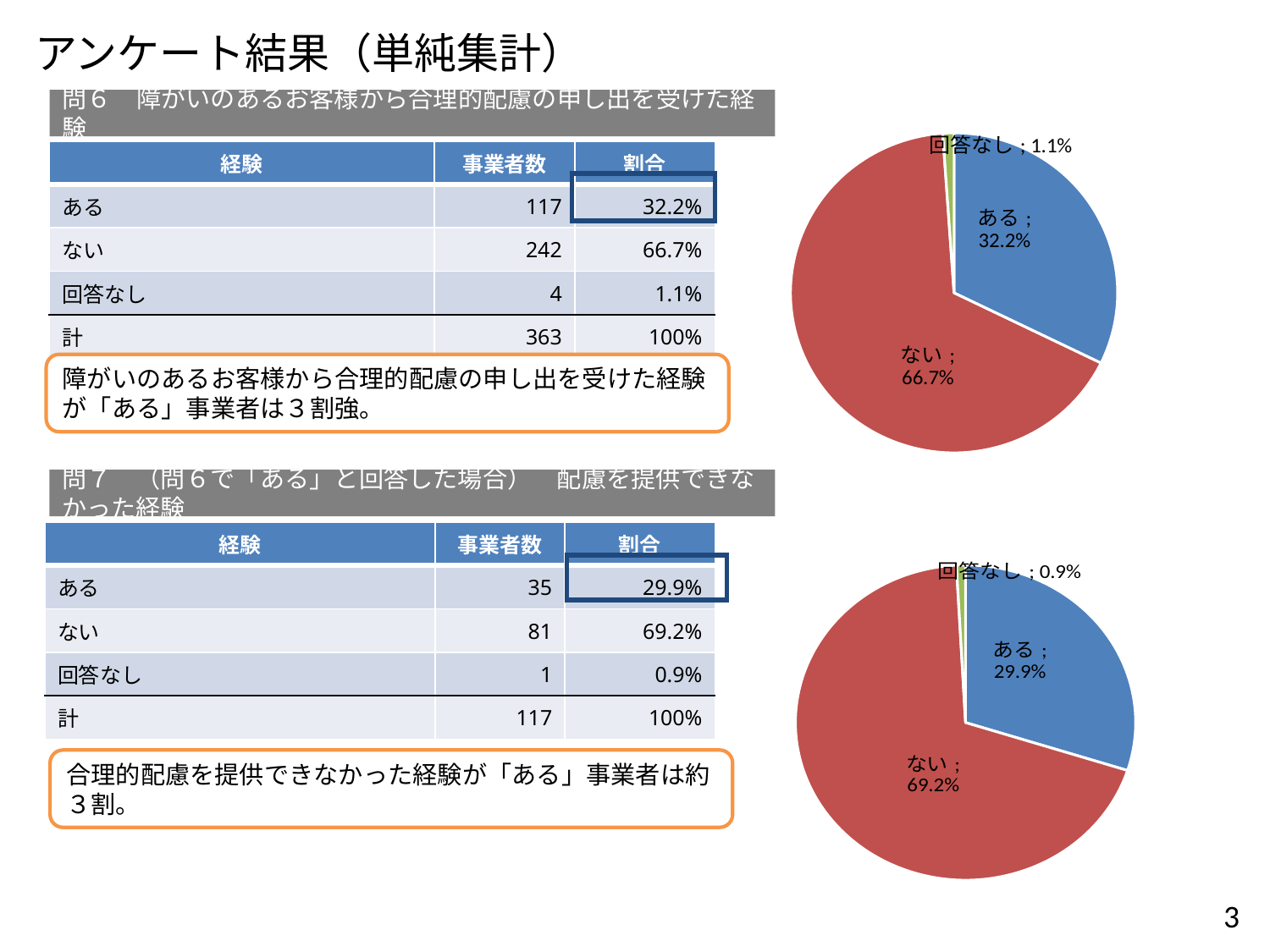
In the bottom pie chart, what share is shown for 回答なし? 0.9% In the bottom pie chart, what share is shown for ない? 69.2% What kind of chart is the top chart on the right side of the slide? pie chart In the bottom pie chart, which is larger, the slice for ある or the slice for ない? ない In the top pie chart, what is the difference between the shares for ない and ある? 34.5% In the top pie chart, which slice is the smallest? 回答なし In the top pie chart, what share is shown for ない? 66.7% In the bottom pie chart, what share is shown for ある? 29.9% How many slices does the bottom pie chart have? 3 In the top pie chart, what share is shown for 回答なし? 1.1% In the top pie chart, what share is shown for ある? 32.2% In the top pie chart, which slice is the largest? ない